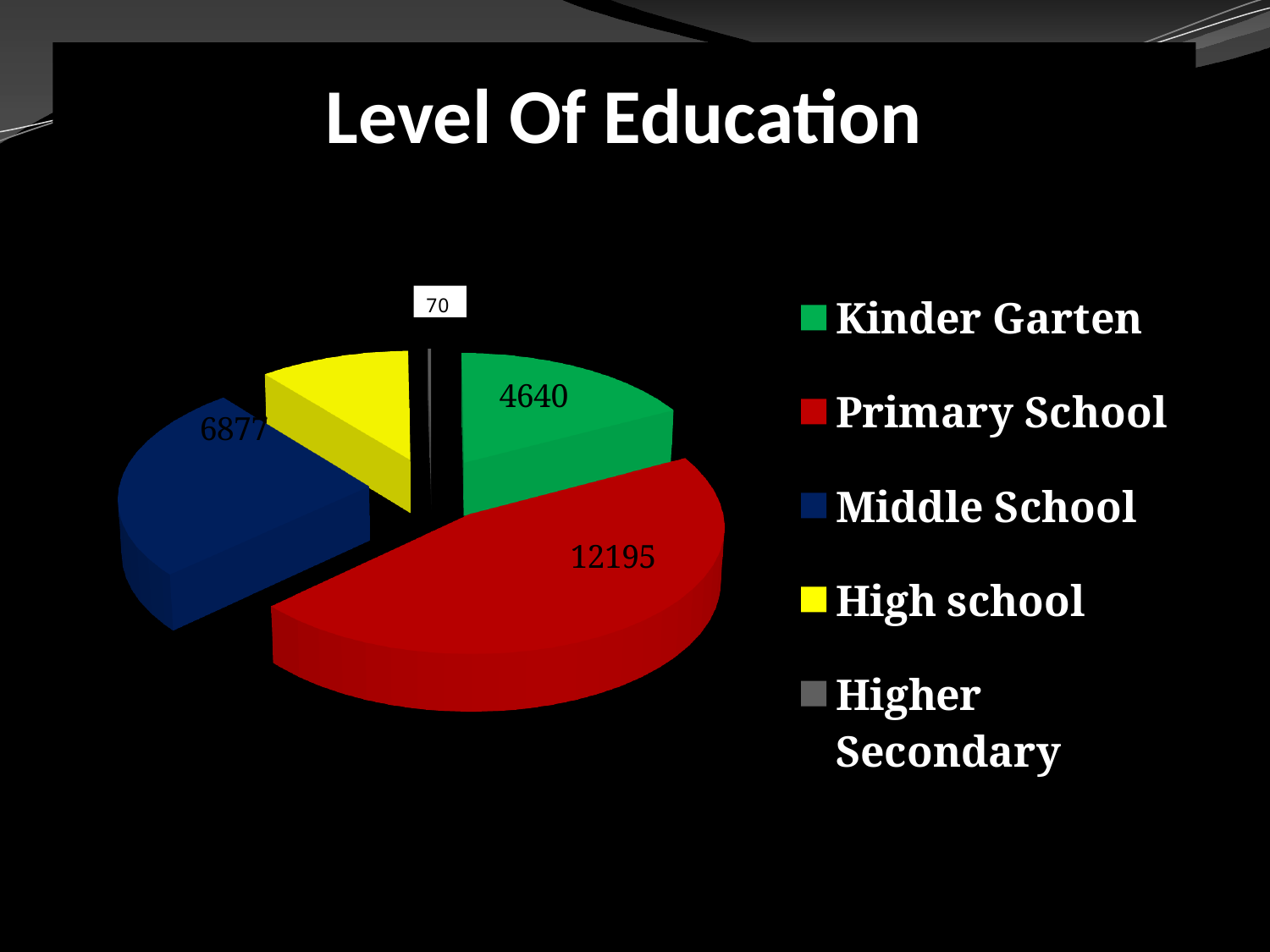
How many categories does the legend list? 5 What is the value for Primary School? 12195 Which level of education has the largest slice? Primary School What is the difference between the values for Middle School and Kinder Garten? 2237 What kind of chart is shown on the slide? pie chart What is the value for Higher Secondary? 70 What is the difference between the values for Primary School and Middle School? 5318 What is the value for Kinder Garten? 4640 Which is larger, the value for Kinder Garten or the value for Middle School? Middle School What is the value for Middle School? 6877 What colour is the Primary School slice? red Which level of education has the smallest slice? Higher Secondary